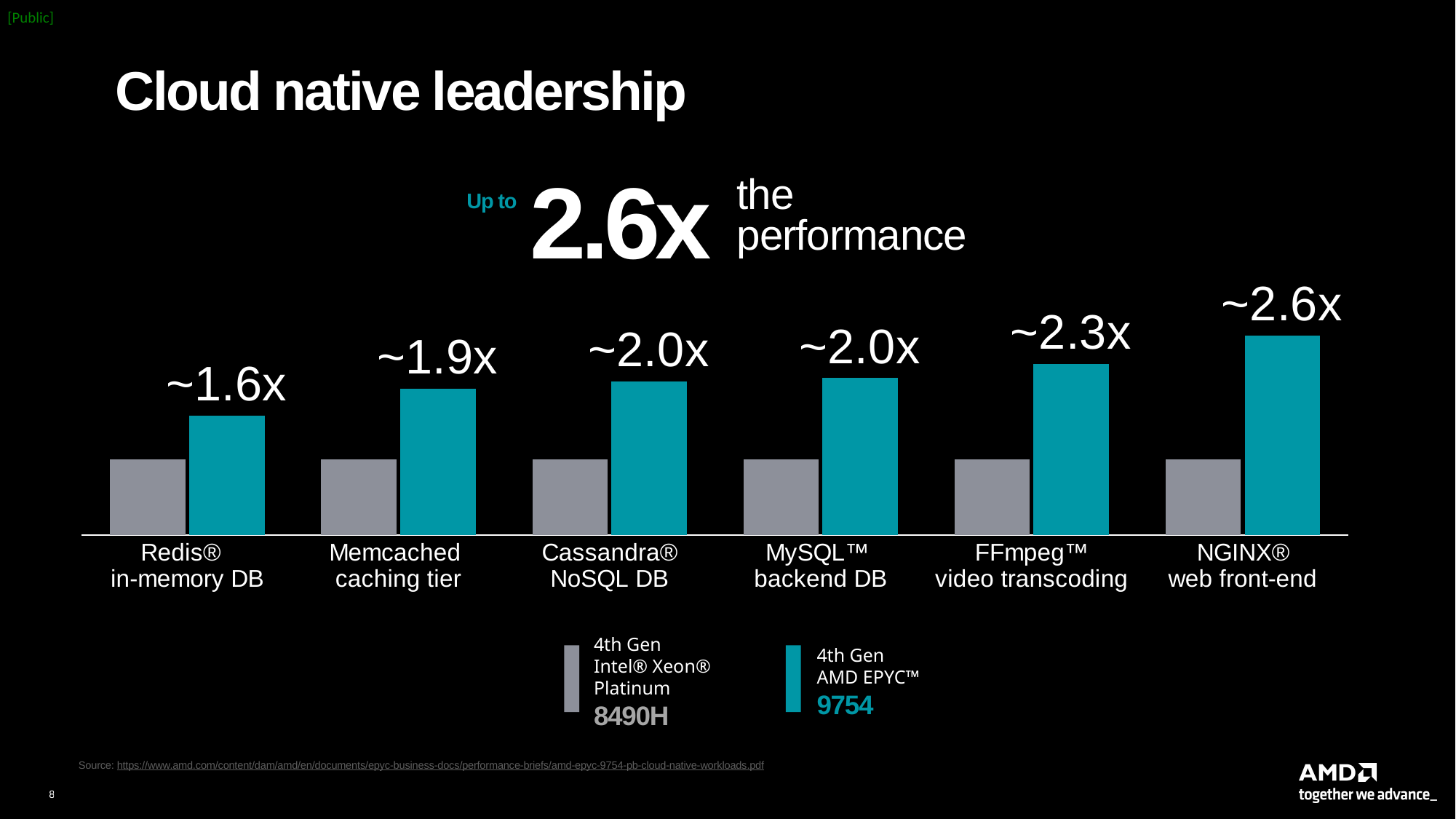
Do the AMD EPYC 9754 performance multiples rise or fall from left to right across the workloads? rise Which workload shows the highest AMD EPYC 9754 performance multiple? NGINX web front-end Which has the larger AMD EPYC 9754 performance multiple, Memcached caching tier or FFmpeg video transcoding? FFmpeg video transcoding How many series does the legend list? 2 How many workload categories are shown along the x axis? 6 Which processor does the grey bar represent in the legend? 4th Gen Intel Xeon Platinum 8490H Which workload shows the lowest AMD EPYC 9754 performance multiple? Redis in-memory DB What performance multiple is labelled for the AMD EPYC 9754 bar on Redis in-memory DB? ~1.6x What performance multiple is labelled for the AMD EPYC 9754 bar on FFmpeg video transcoding? ~2.3x What performance multiple is labelled for the AMD EPYC 9754 bar on Memcached caching tier? ~1.9x What kind of chart is shown on the slide? bar chart What is the title of the slide containing the chart? Cloud native leadership